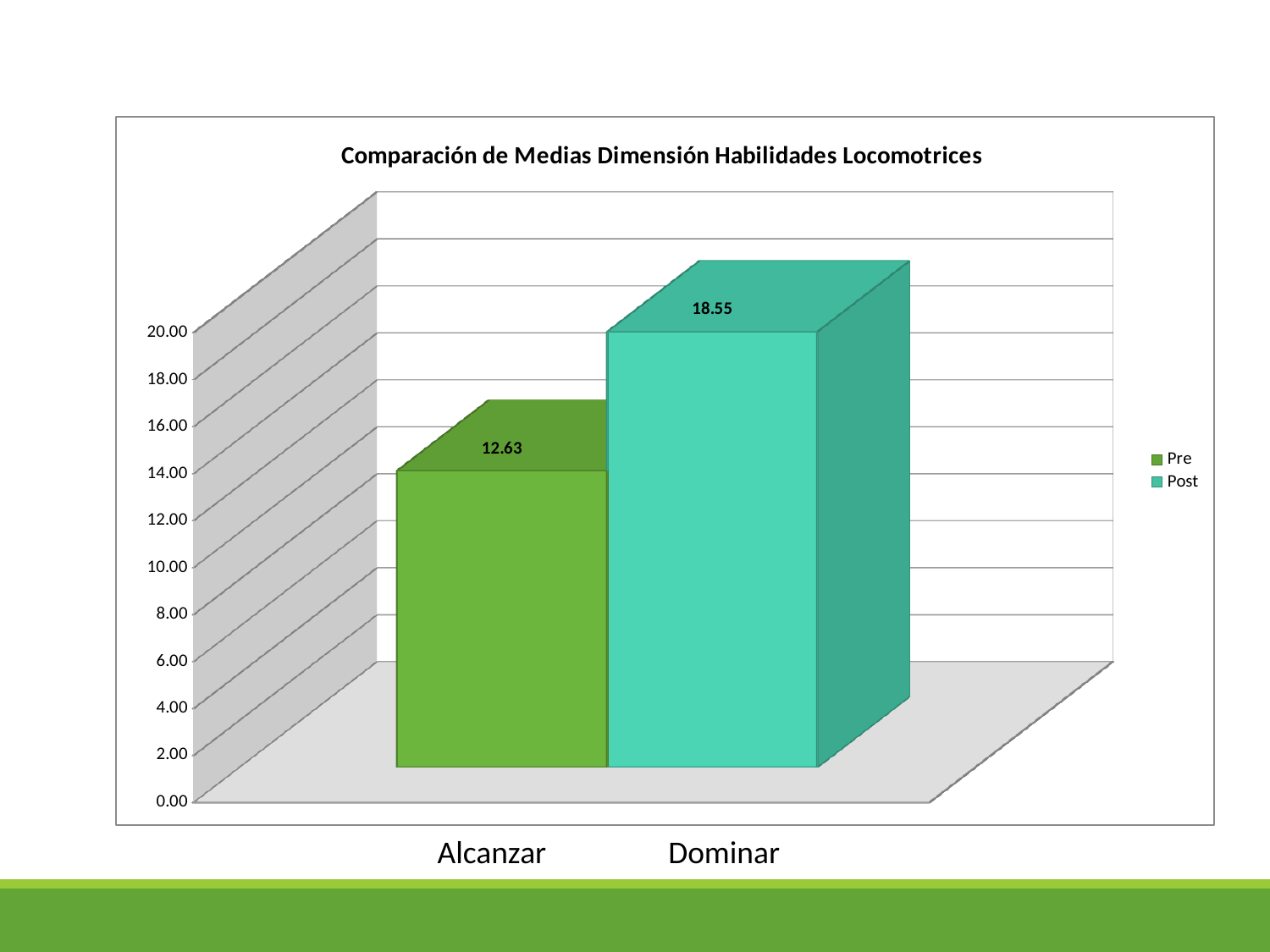
Which bar is the highest in the chart? Post What kind of chart is shown on the slide? Bar chart What is the difference between the Post value and the Pre value? 5.92 How many series does the legend list? 2 Which bar is the lowest in the chart? Pre How many bars are plotted in the chart? 2 Is the value for Post greater or less than 16.00? greater What is the title of the chart? Comparación de Medias Dimensión Habilidades Locomotrices What is the value of the Post bar? 18.55 Which series has the higher value, Pre or Post? Post What is the value of the Pre bar? 12.63 Is the value for Pre greater or less than 14.00? less